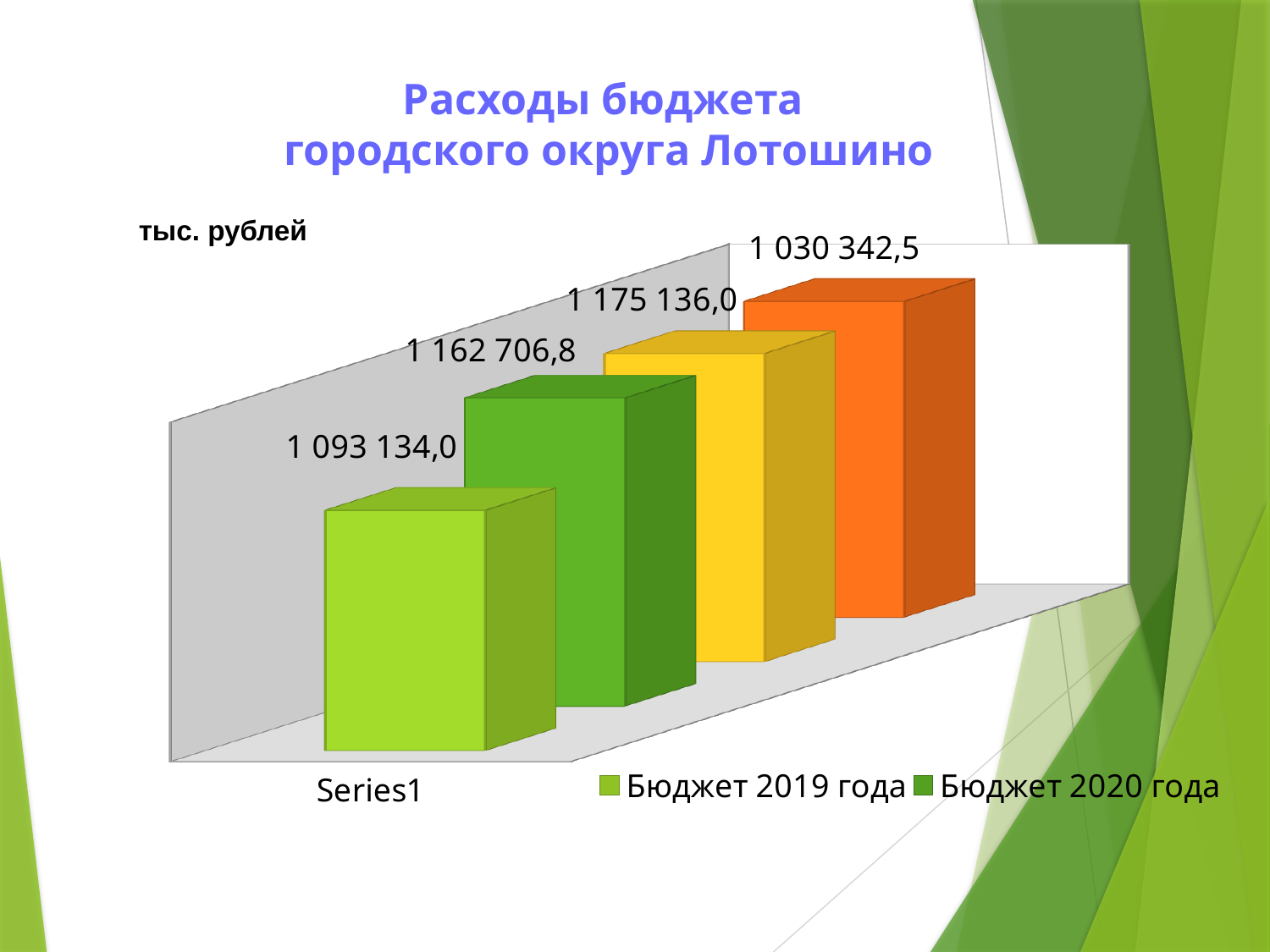
Which bar has the highest value? The yellow bar (1 175 136,0) By how much does Бюджет 2020 года exceed Бюджет 2019 года? 69 572,8 What value is labelled on the yellow bar? 1 175 136,0 What is the difference between the yellow bar and the orange bar? 144 793,5 How many bars are plotted on the chart? 4 What unit of measurement is indicated for the chart values? тыс. рублей What value is labelled on the orange bar? 1 030 342,5 What is the value for Бюджет 2020 года? 1 162 706,8 How many series does the legend list? 2 What is the value for Бюджет 2019 года? 1 093 134,0 Which bar has the lowest value? The orange bar (1 030 342,5) Which is larger, Бюджет 2019 года or Бюджет 2020 года? Бюджет 2020 года